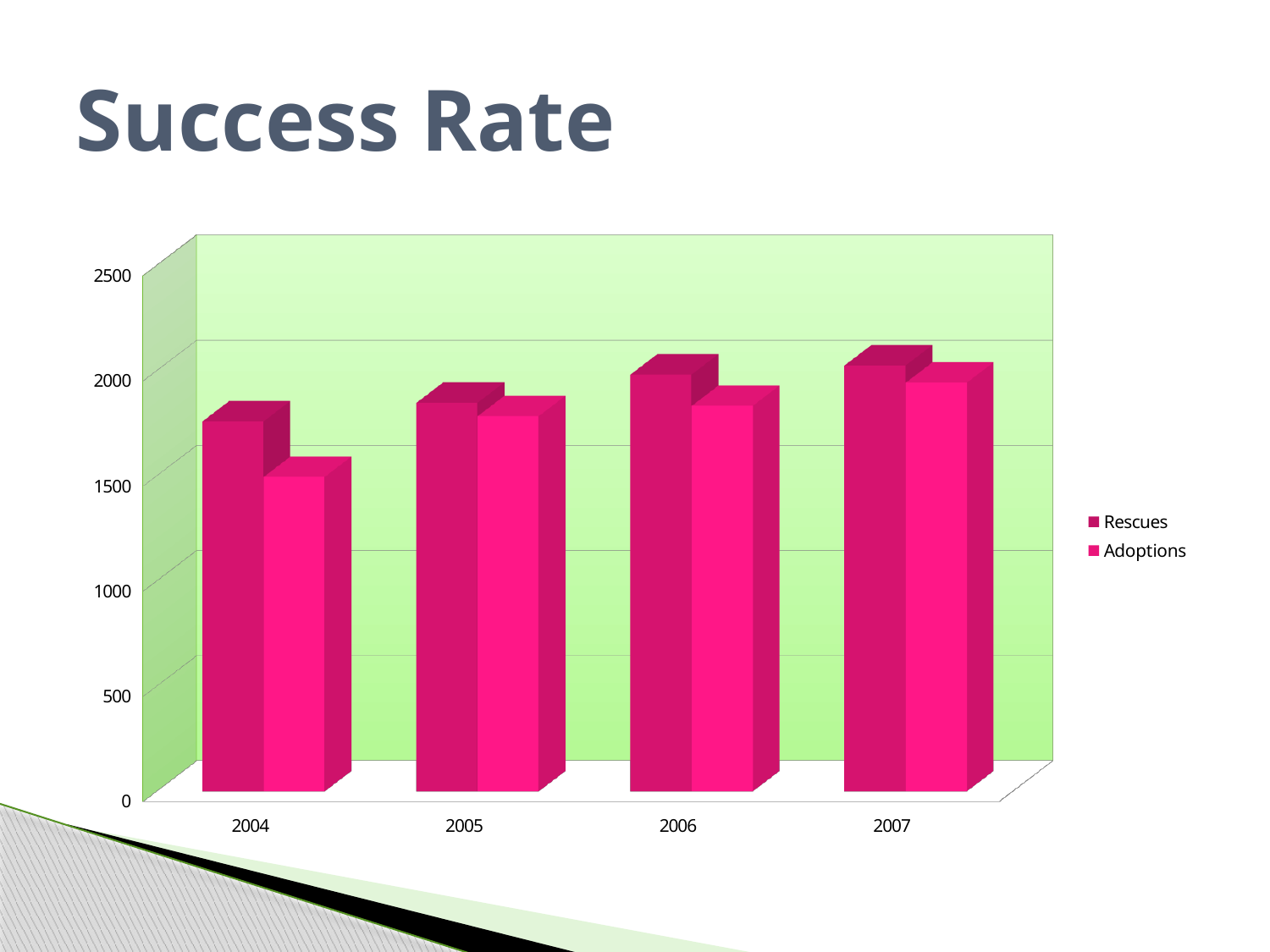
In 2004, which is larger, Rescues or Adoptions? Rescues What kind of chart is shown on the slide? bar chart What are the two series named in the legend? Rescues and Adoptions In which year is the Adoptions value lowest? 2004 How many series does the legend list? 2 Is the Rescues value for 2005 greater or less than 1500? greater Is the Rescues value for 2004 greater or less than 2000? less Is the Adoptions value for 2004 greater or less than 2000? less What is the title of the chart? Success Rate In which year is the Rescues value lowest? 2004 Do the Adoptions values rise or fall from 2004 to 2007? rise How many years are shown on the x axis? 4